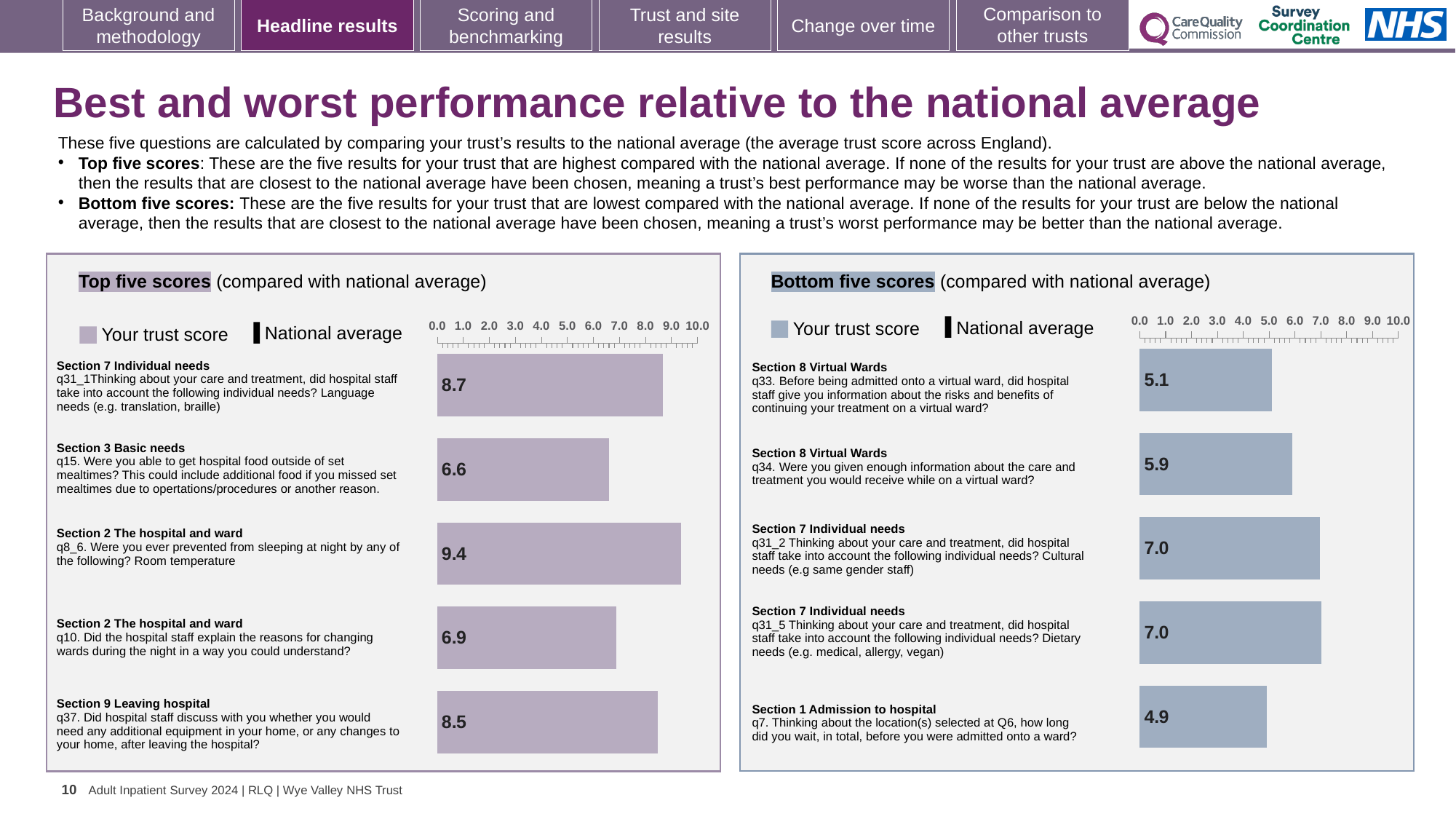
In the Top five scores chart, which question has the lowest trust score? q15 (hospital food outside of set mealtimes) In the Bottom five scores chart, which question has the lowest trust score? q7 (wait before admitted onto a ward) In the Top five scores chart, what is the trust score for q15 (hospital food outside of set mealtimes)? 6.6 In the Top five scores chart, which question has the highest trust score? q8_6 (Room temperature) What type of chart is used in the Top five scores panel? Bar chart In the Bottom five scores chart, what is the trust score for q7 (how long did you wait before being admitted onto a ward)? 4.9 In the Bottom five scores chart, what is the difference between the trust scores for q34 and q33? 0.8 In the Top five scores chart, what is the trust score for q8_6 (prevented from sleeping at night by room temperature)? 9.4 In the Top five scores chart, which has the larger trust score: q10 (reasons for changing wards) or q37 (additional equipment after leaving hospital)? q37 How many bars are plotted in the Bottom five scores chart? 5 In the Top five scores chart, what is the difference between the trust scores for q31_1 (Language needs) and q37 (additional equipment after leaving hospital)? 0.2 In the Bottom five scores chart, what is the trust score for q34 (enough information about care and treatment on a virtual ward)? 5.9